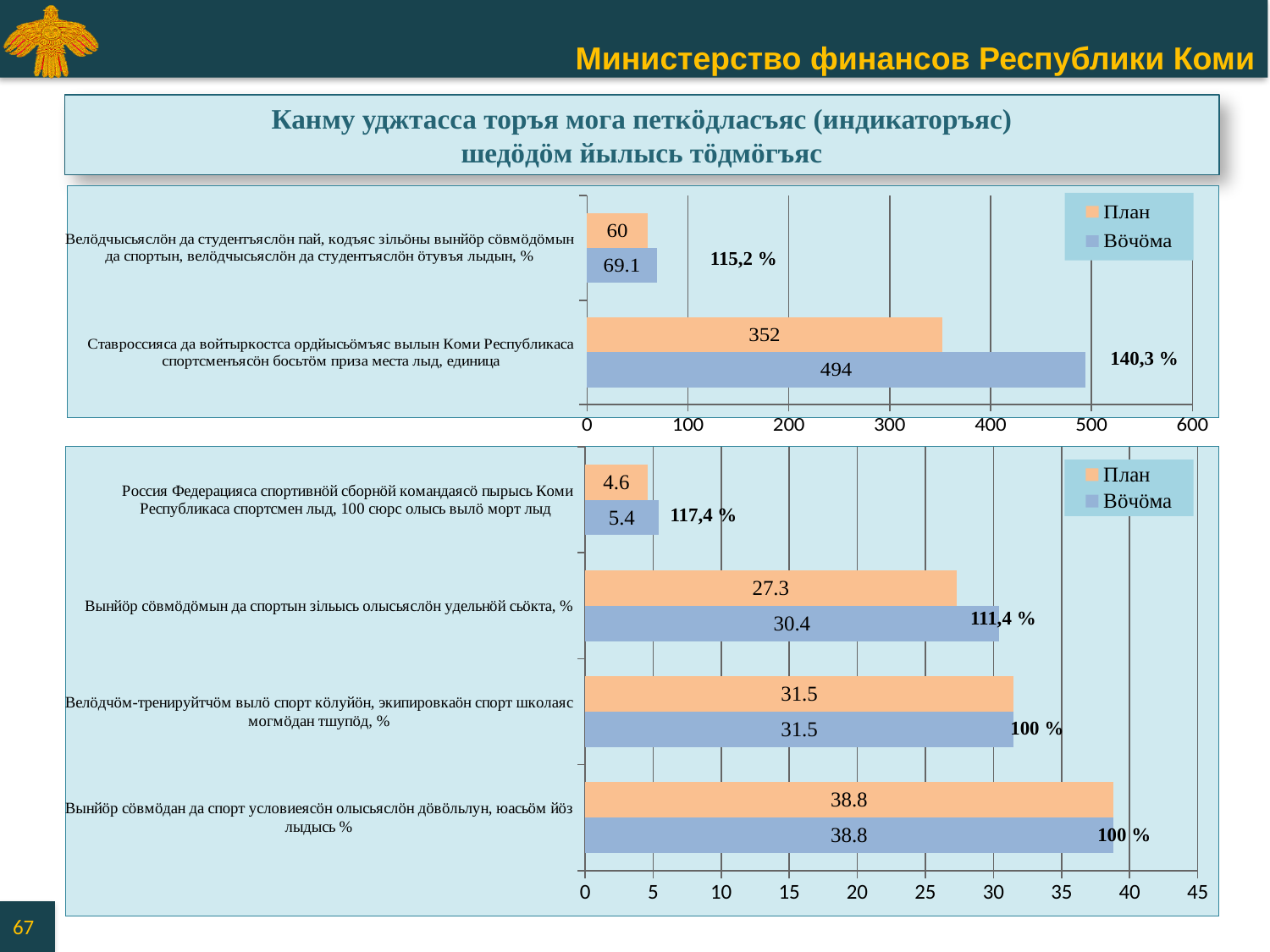
How many series does the legend of the top chart list? 2 What kind of chart is the bottom chart? bar chart In the top chart, what is the План value for the category about the share of pupils and students engaged in physical culture and sport (Велöдчысьяслöн да студентъяслöн пай...)? 60 In the top chart, what percentage is printed next to the bars for the prize places category (Ставроссияса да войтыркостса ордйысьöмъяс...)? 140,3 % In the bottom chart, what is the План value for the category about Komi athletes in Russian national teams per 100 thousand people (Россия Федерацияса спортивнöй сборнöй командаясö пырысь...)? 4.6 In the bottom chart, what is the Вöчöма value for the category about the share of the population engaged in physical culture and sport (Вынйöр сöвмöдöмын да спортын зiльысь олысьяслöн удельнöй сьöкта, %)? 30.4 In the bottom chart, what percentage is printed next to the bars for the category about satisfaction with conditions for physical culture and sport (Вынйöр сöвмöдан да спорт условиеясöн олысьяслöн дöвöльлун...)? 100 % How many categories are shown in the bottom chart? 4 In the top chart, what is the Вöчöма value for the category about prize places won by Komi athletes at all-Russian and international competitions (Ставроссияса да войтыркостса ордйысьöмъяс...)? 494 In the top chart, what is the difference between the Вöчöма and План values for the prize places category (Ставроссияса да войтыркостса ордйысьöмъяс...)? 142 In the bottom chart, which category has the highest Вöчöма value? Вынйöр сöвмöдан да спорт условиеясöн олысьяслöн дöвöльлун, юасьöм йöз лыдысь % In the bottom chart, is the План value larger for the category about sport school equipment (Велöдчöм-тренируйтчöм вылö спорт кöлуйöн...) or for the category about the share of the population engaged in sport (Вынйöр сöвмöдöмын да спортын зiльысь олысьяслöн удельнöй сьöкта, %)? Велöдчöм-тренируйтчöм вылö спорт кöлуйöн, экипировкаöн спорт школаяс могмöдан тшупöд, %